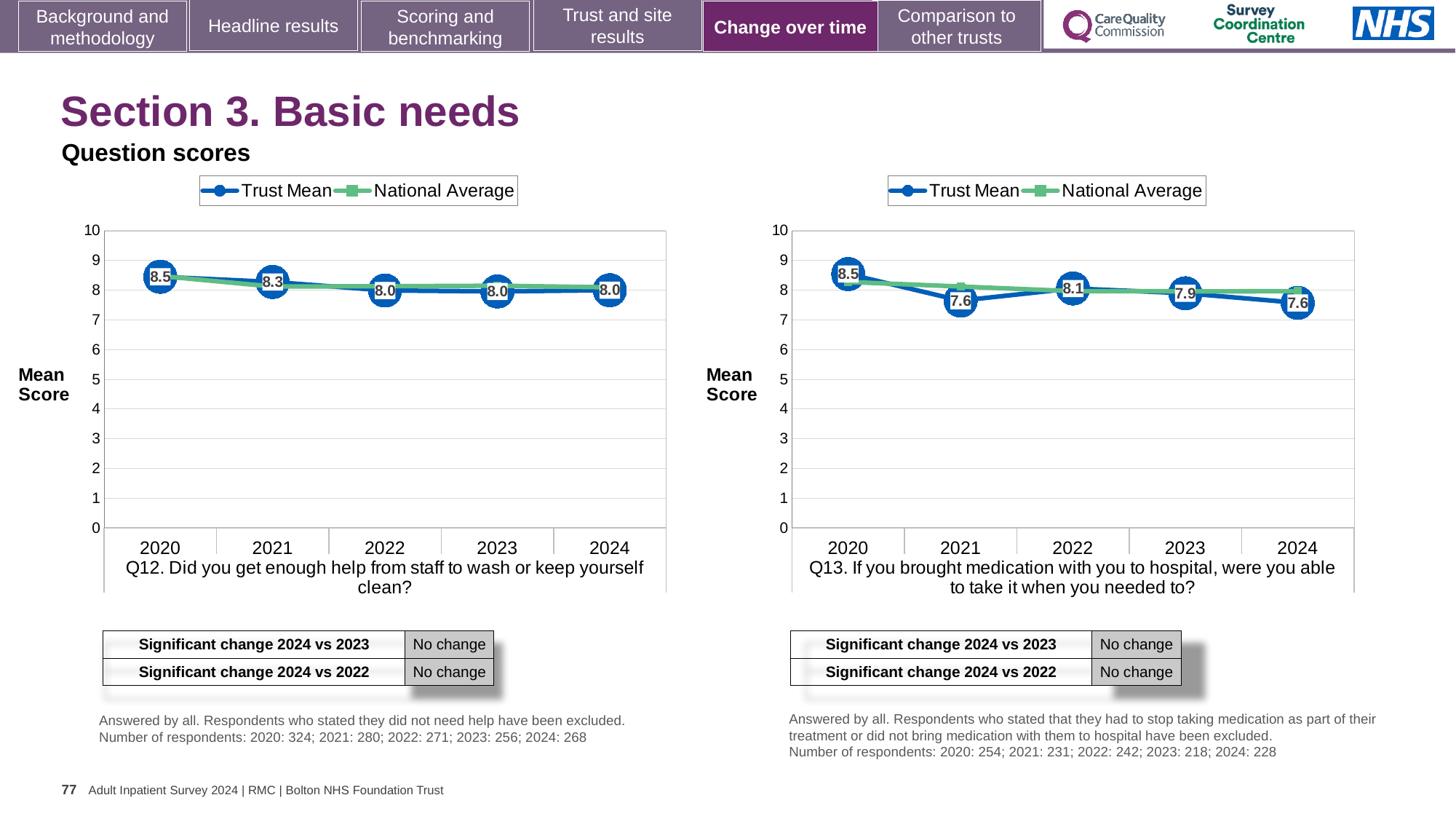
In the Q13 chart on the right, which year has the larger Trust Mean score, 2022 or 2023? 2022 In the Q13 chart on the right, what is the Trust Mean score for 2021? 7.6 How many series does the legend of the Q13 chart on the right list? 2 In the Q13 chart on the right, is the National Average value for 2024 greater or less than 7? greater In the Q12 chart on the left, which year has the highest Trust Mean score? 2020 In the Q13 chart on the right, what is the Trust Mean score for 2023? 7.9 In the Q12 chart on the left, what is the Trust Mean score for 2020? 8.5 In the Q12 chart on the left, what is the difference between the Trust Mean scores for 2020 and 2024? 0.5 In the Q12 chart on the left, what is the Trust Mean score for 2021? 8.3 How many years are shown on the x axis of the Q12 chart on the left? 5 In the Q13 chart on the right, what is the difference between the Trust Mean scores for 2020 and 2021? 0.9 In the Q13 chart on the right, which year has the highest Trust Mean score? 2020